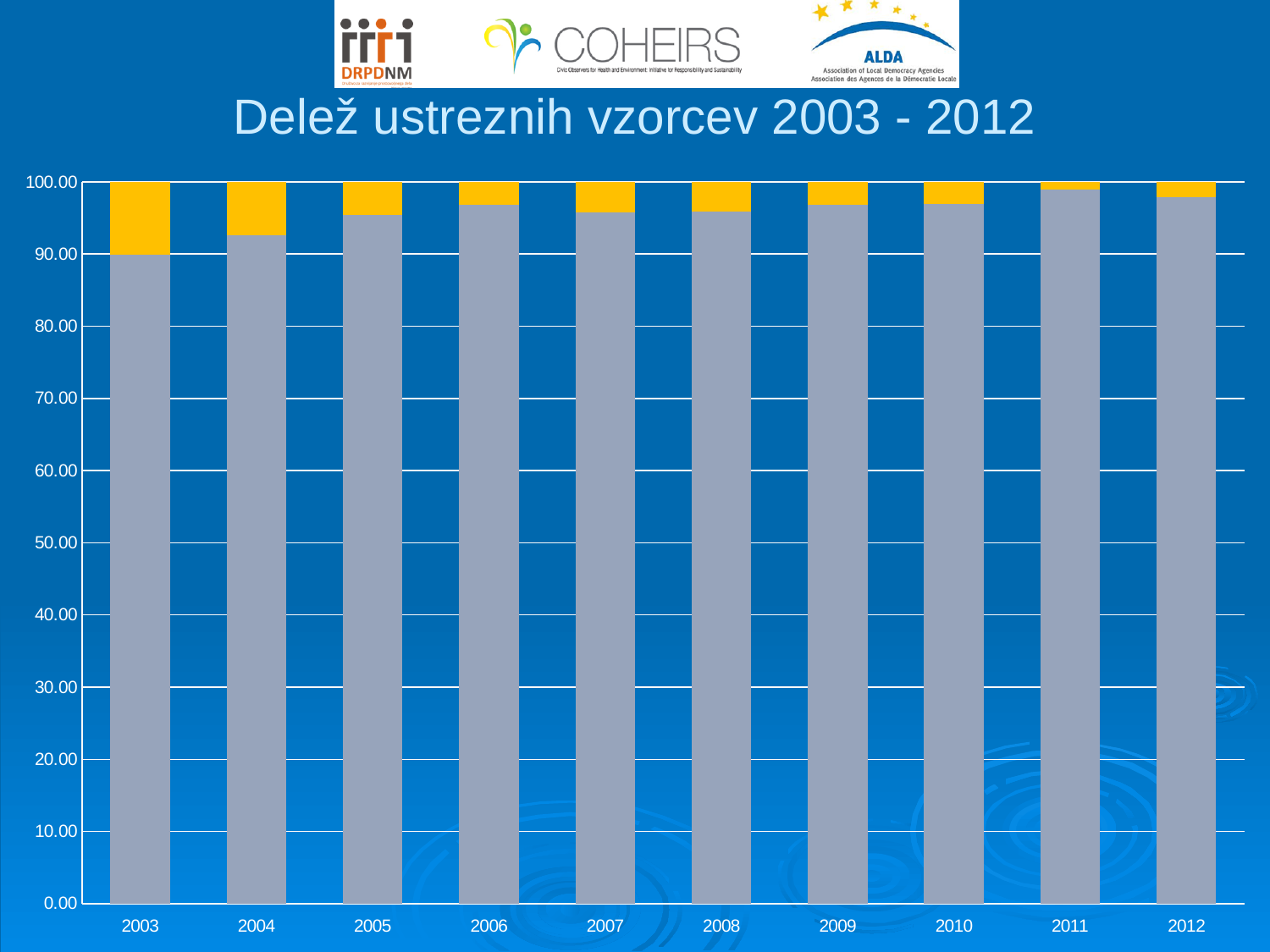
What is the title of the chart? Delež ustreznih vzorcev 2003 - 2012 Is the grey segment for 2005 greater or less than 90.00? greater Is the grey segment for 2011 greater or less than 90.00? greater Which year has the larger yellow segment, 2003 or 2011? 2003 How many years (categories) are shown on the x axis? 10 What kind of chart is shown on the slide? Stacked bar chart Is the grey segment for 2004 greater or less than 90.00? greater Which year has the larger grey segment, 2003 or 2004? 2004 Which year has the largest yellow (upper) segment? 2003 Which year has the smallest grey (lower) segment? 2003 What is the total height of the stacked bar for 2003? 100.00 Which year has the largest grey (lower) segment? 2011